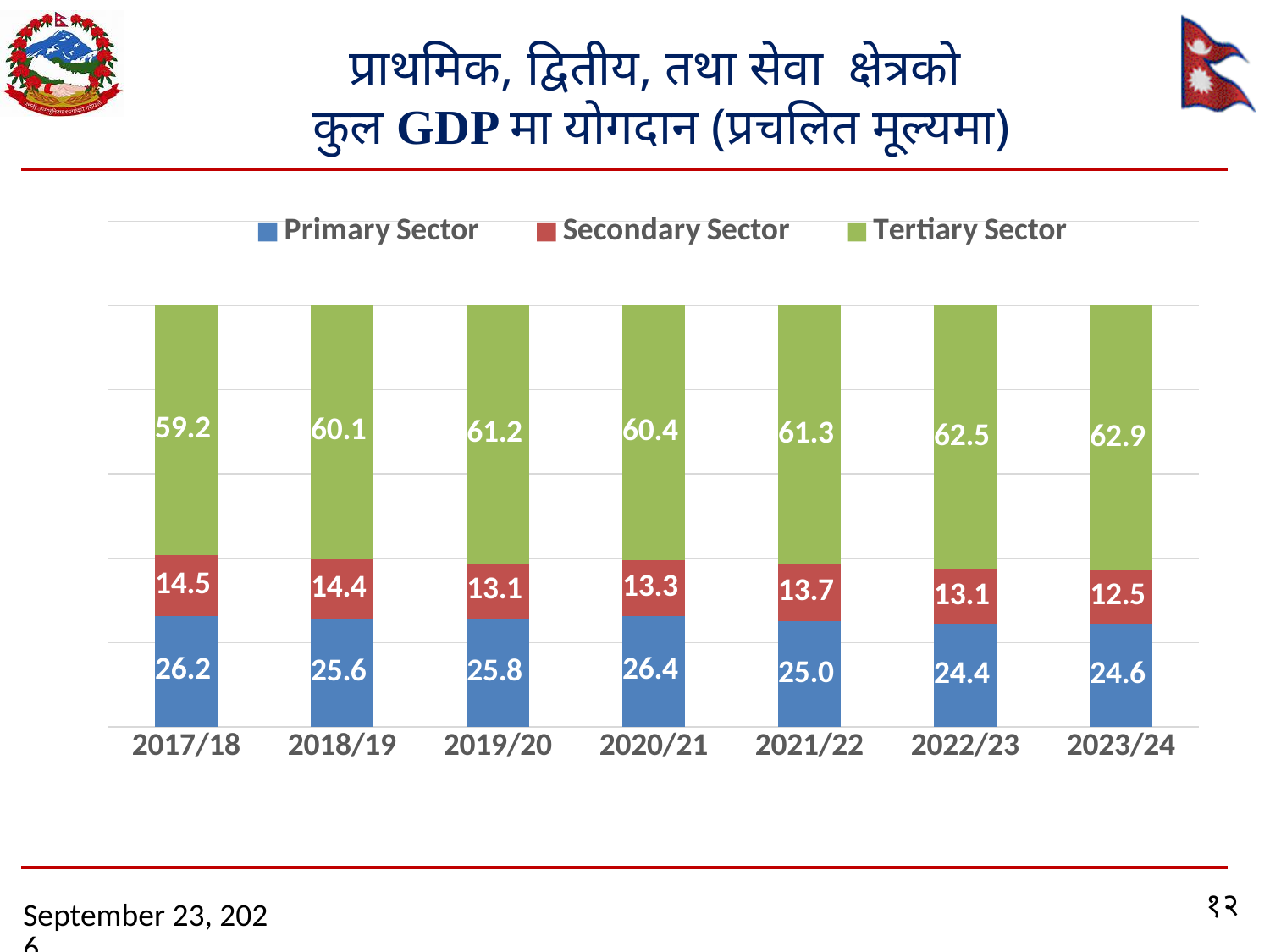
What is the total of the stacked bar for 2021/22? 100.0 What is the difference between the Tertiary Sector values in 2023/24 and 2017/18? 3.7 In which year is the Primary Sector value lowest? 2022/23 How many years are shown on the x axis? 7 What is the value for the Primary Sector in 2017/18? 26.2 What is the value for the Secondary Sector in 2021/22? 13.7 In which year is the Tertiary Sector value highest? 2023/24 What is the value for the Tertiary Sector in 2023/24? 62.9 Does the Tertiary Sector value generally rise or fall from 2017/18 to 2023/24? Rise What kind of chart is shown on the slide? Stacked bar chart Which is larger, the Secondary Sector value in 2017/18 or in 2023/24? 2017/18 How many series does the legend list? 3